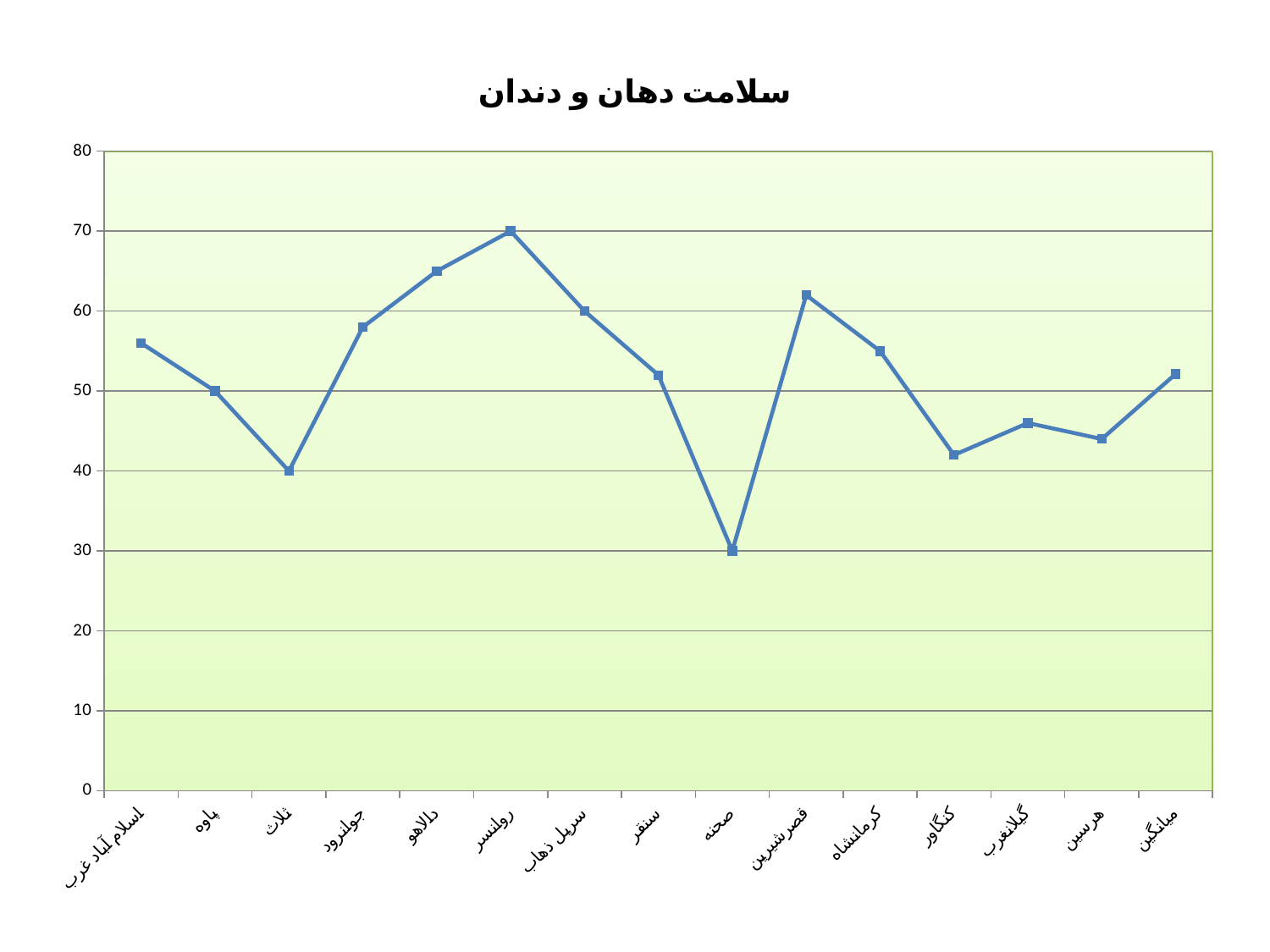
Which has the larger value, دالاهو or کرمانشاه? دالاهو What kind of chart is shown on the slide? Line chart Which category has the lowest value? صحنه What is the value for ثلاث? 40 How many categories are plotted along the x axis? 15 Which category has the highest value? روانسر Is the value for دالاهو greater or less than 60? greater What is the value for صحنه? 30 What is the title of the chart? سلامت دهان و دندان What is the value for روانسر? 70 What is the difference between the values for روانسر and صحنه? 40 Do the values rise or fall from ثلاث to روانسر? Rise